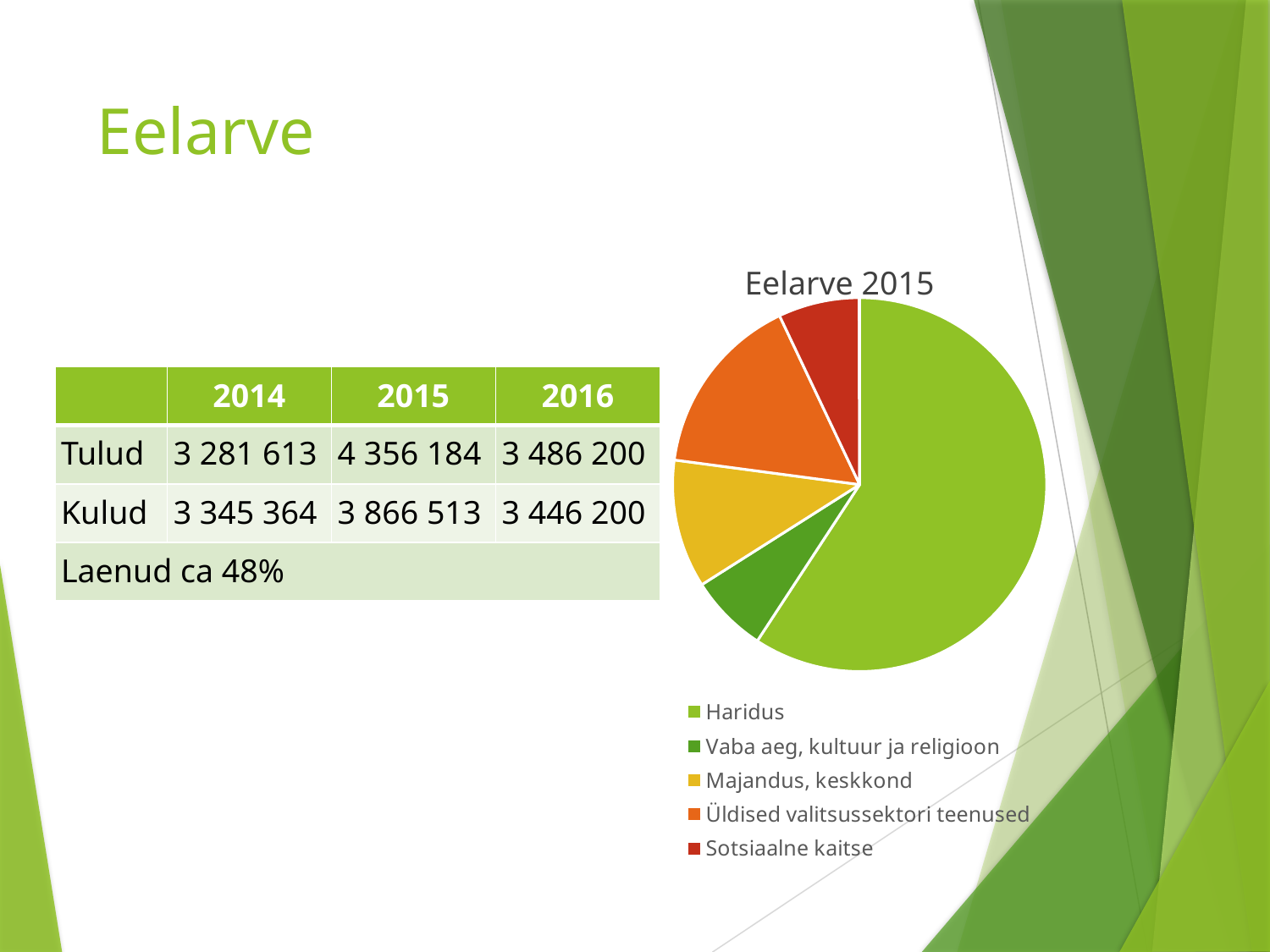
Which slice is larger in the pie chart: Haridus or Majandus, keskkond? Haridus What kind of chart is shown on the slide? pie chart Which slice is larger in the pie chart: Üldised valitsussektori teenused or Vaba aeg, kultuur ja religioon? Üldised valitsussektori teenused How many slices does the pie chart have? 5 Which legend entry is shown in red in the pie chart? Sotsiaalne kaitse Does the Haridus slice make up more or less than half of the pie chart? more Which slice is larger in the pie chart: Haridus or Sotsiaalne kaitse? Haridus Which category has the largest slice in the pie chart? Haridus How many entries does the legend of the pie chart list? 5 What is the title of the pie chart? Eelarve 2015